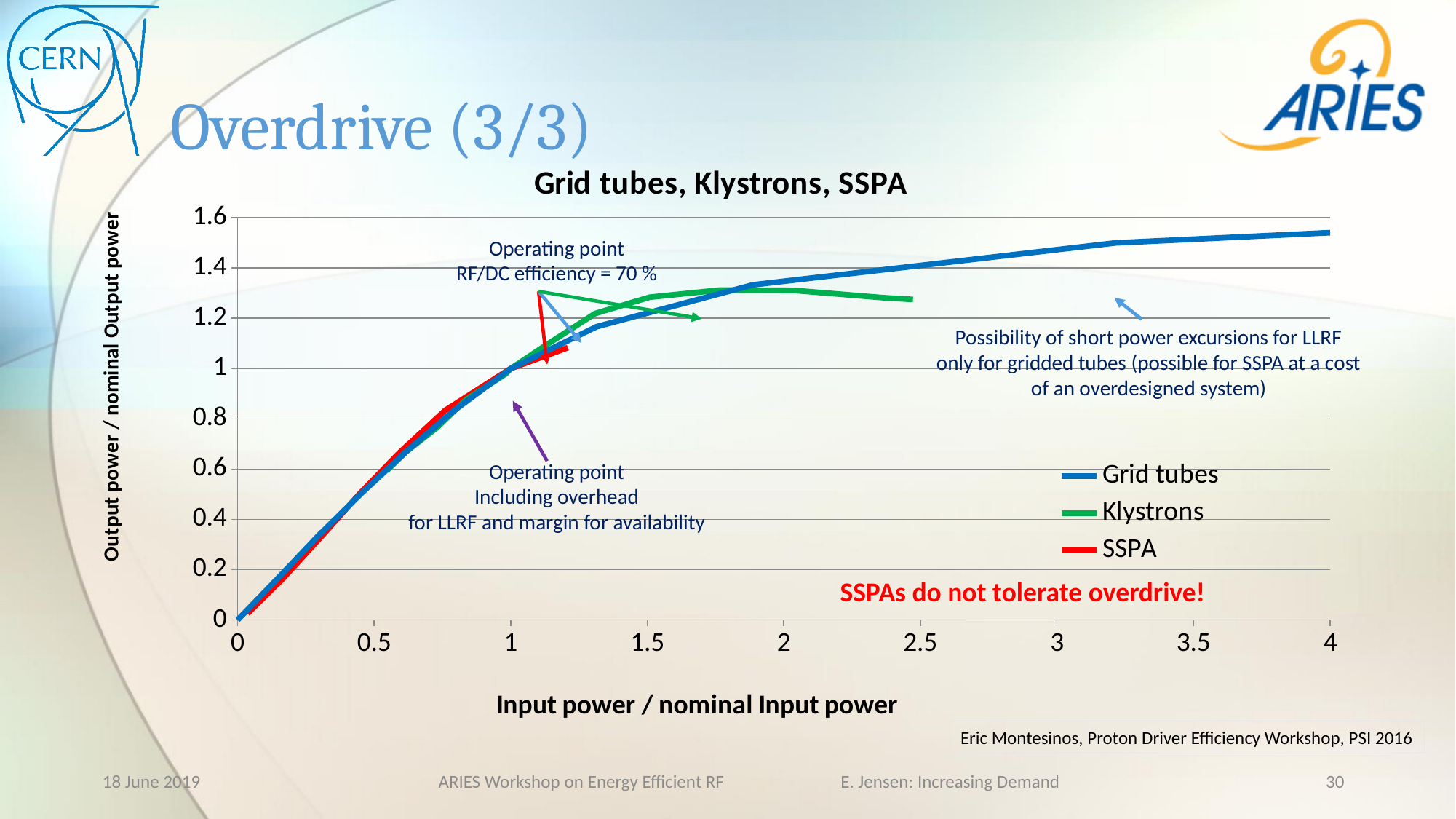
What is the label of the x axis? Input power / nominal Input power What kind of chart is shown on the slide? Line chart Is the value for Grid tubes at an input power of 0.5 greater or less than 0.8? less Is the value for Grid tubes at an input power of 4 greater or less than 1.4? greater How many series does the legend list? 3 Is the value for Grid tubes at an input power of 3 greater or less than 1.2? greater What is the title of the chart? Grid tubes, Klystrons, SSPA At an input power of 2.5, which series has the higher output power, Grid tubes or Klystrons? Grid tubes Does the Grid tubes curve rise or fall as input power increases from 0 to 4? rise Which series reaches the highest output power on the chart? Grid tubes Which series ends at the lowest input power value on the chart? SSPA